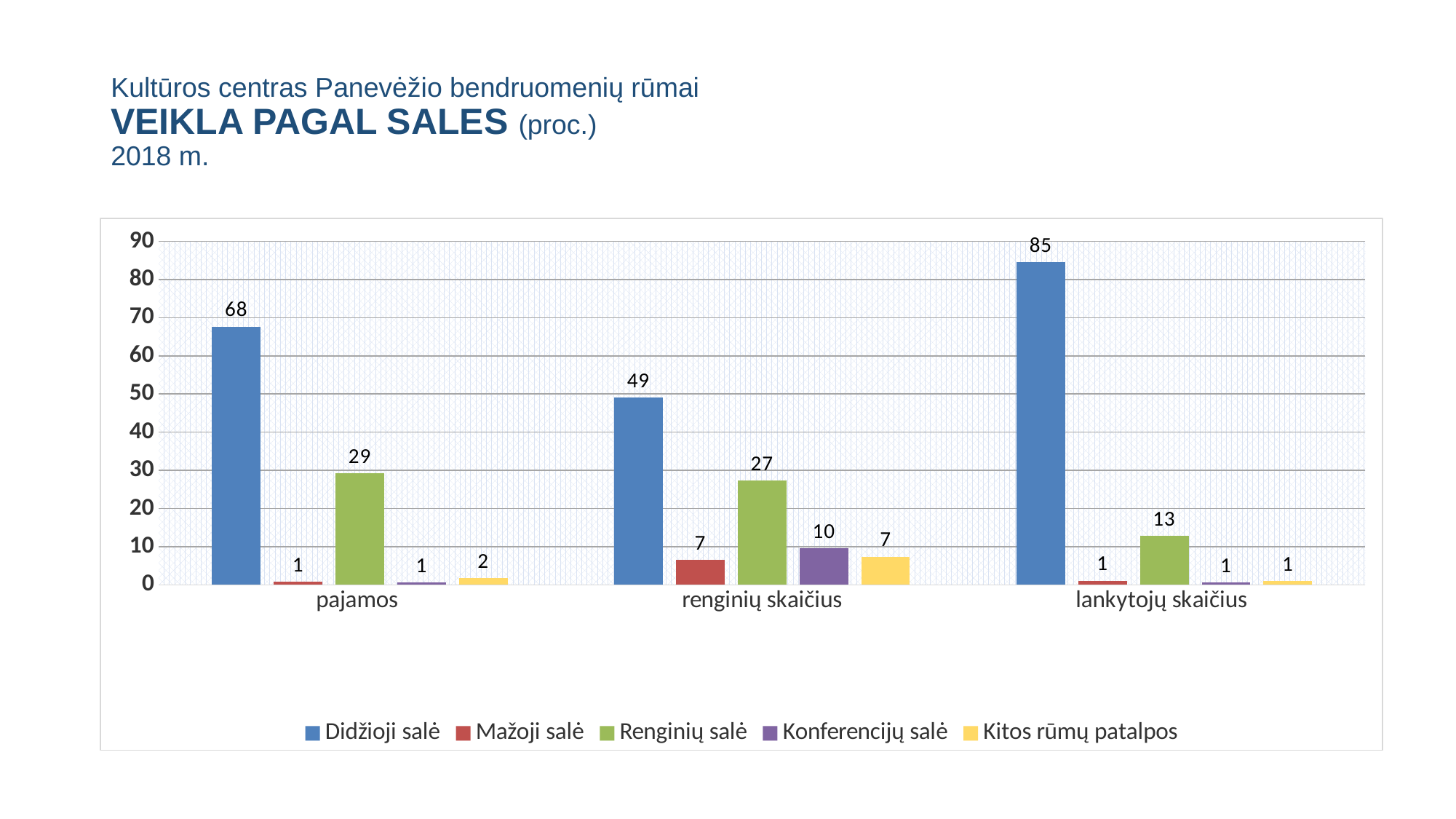
What kind of chart is shown on the slide? bar chart What is the value for Renginių salė in the renginių skaičius category? 27 What is the value for Konferencijų salė in the renginių skaičius category? 10 What is the value for Didžioji salė in the pajamos category? 68 How many categories are shown on the x axis? 3 Which series has the highest value in the lankytojų skaičius category? Didžioji salė In which category does Didžioji salė have its lowest value? renginių skaičius What is the value for Renginių salė in the lankytojų skaičius category? 13 Which is larger: Renginių salė in pajamos or Renginių salė in renginių skaičius? Renginių salė in pajamos What is the difference between the Didžioji salė values for lankytojų skaičius and pajamos? 17 What is the value for Kitos rūmų patalpos in the renginių skaičius category? 7 How many series does the legend list? 5